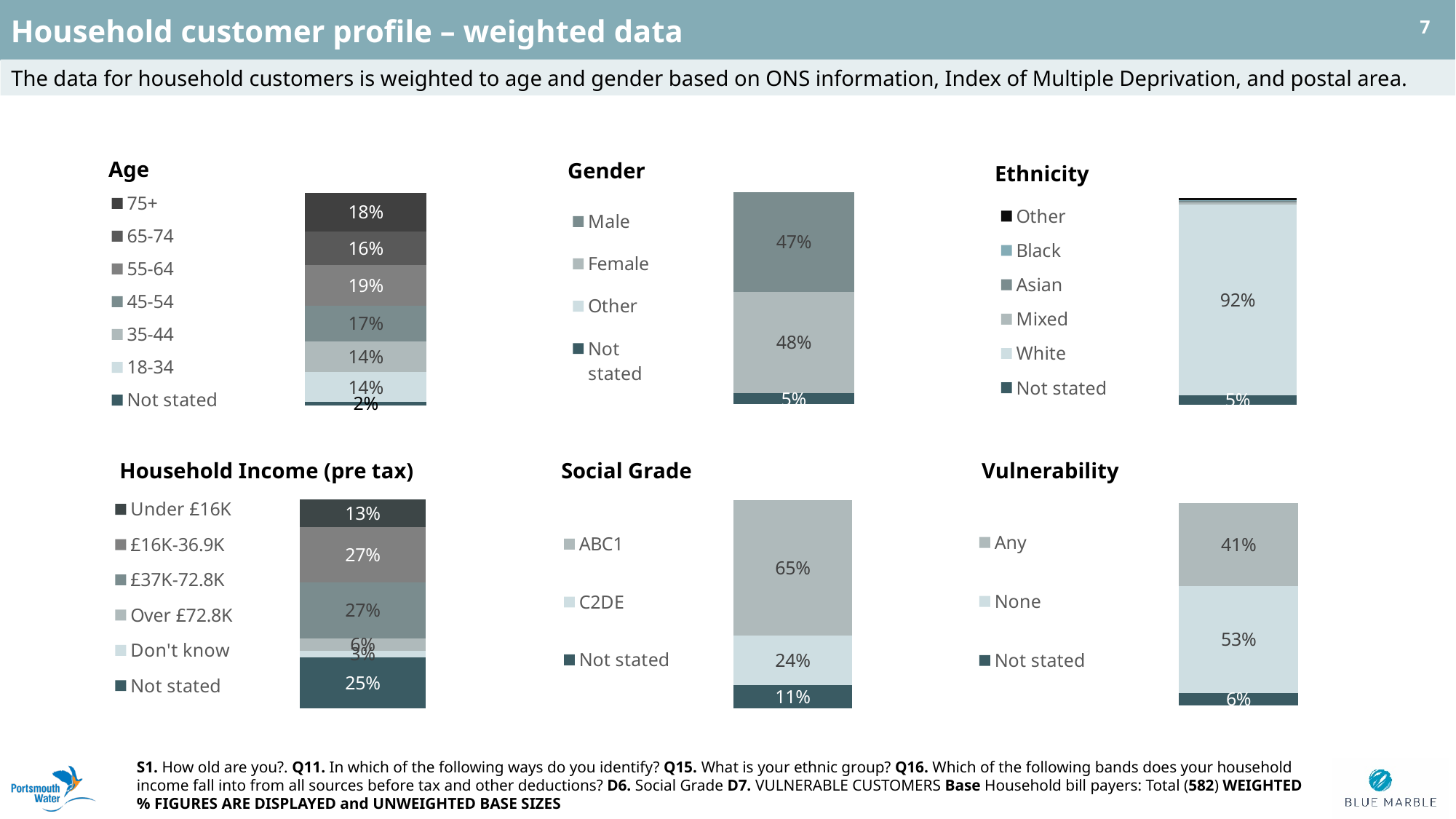
What kind of chart is the Social Grade chart? Stacked bar chart In the Vulnerability chart, what percentage is None? 53% In the Vulnerability chart, which is larger, Any or None? None In the Gender chart, what percentage is Female? 48% In the Social Grade chart, what percentage is ABC1? 65% In the Social Grade chart, what is the difference between ABC1 and C2DE? 41% In the Household Income (pre tax) chart, what percentage is Not stated? 25% How many entries does the legend of the Household Income (pre tax) chart list? 6 In the Gender chart, what is the difference between Female and Male? 1% In the Ethnicity chart, what percentage is White? 92% In the Age chart, what percentage is 55-64? 19% In the Age chart, which age group has the highest percentage? 55-64